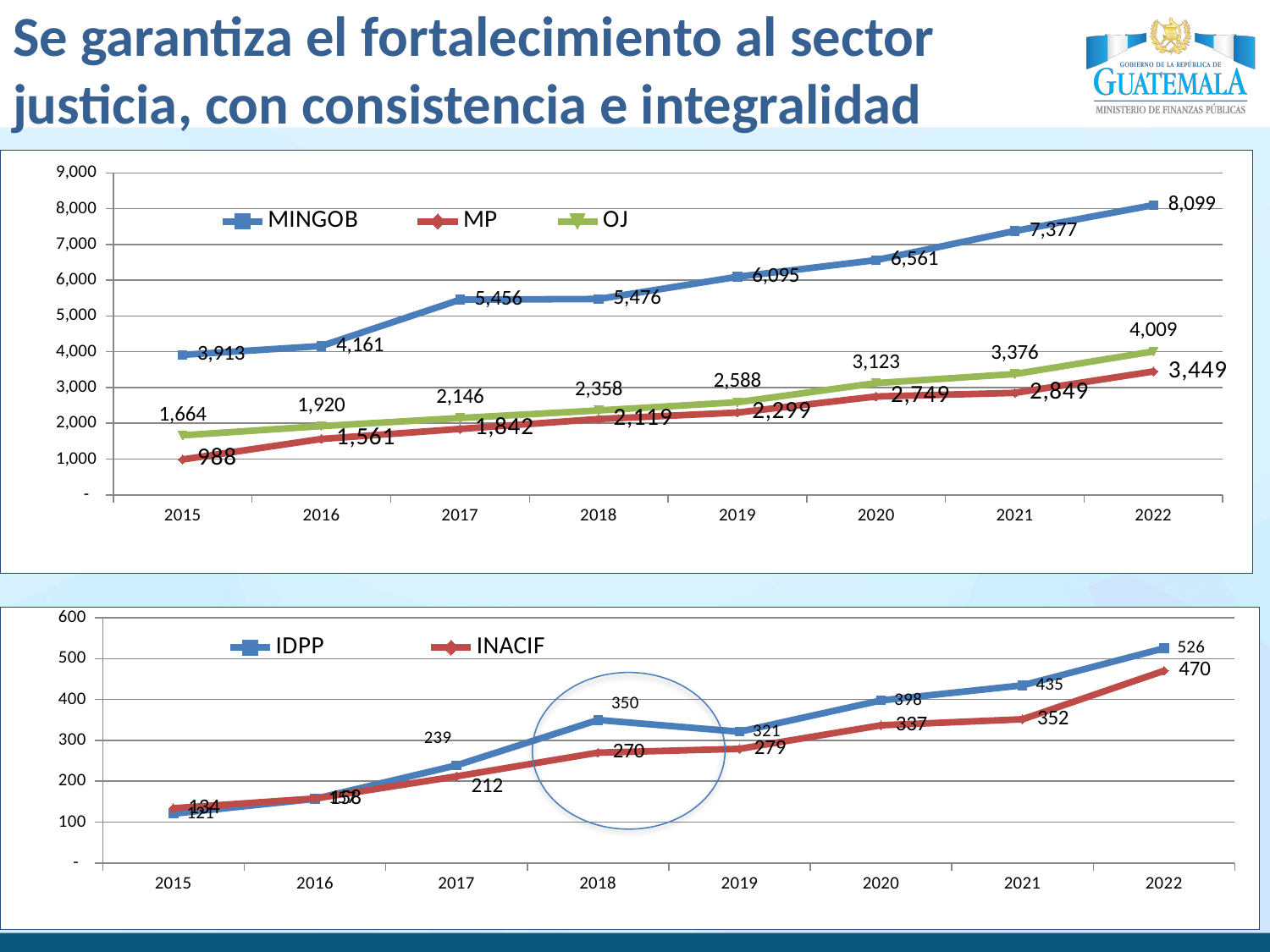
How many series does the legend of the top chart list? 3 In the top chart, do the MINGOB values rise or fall from 2015 to 2022? Rise In the top chart, what is the value for OJ in 2020? 3,123 What kind of chart is the top chart? Line chart In the top chart, what is the value for MP in 2015? 988 In the top chart, what is the value for MINGOB in 2022? 8,099 In the top chart, what is the difference between the MINGOB values for 2022 and 2015? 4,186 In the bottom chart, in which year is the IDPP value highest? 2022 In the bottom chart, what is the difference between the IDPP and INACIF values in 2022? 56 In the bottom chart, what is the value for INACIF in 2022? 470 In the top chart, which is larger in 2019, the value for OJ or the value for MP? OJ In the bottom chart, what is the value for IDPP in 2018? 350